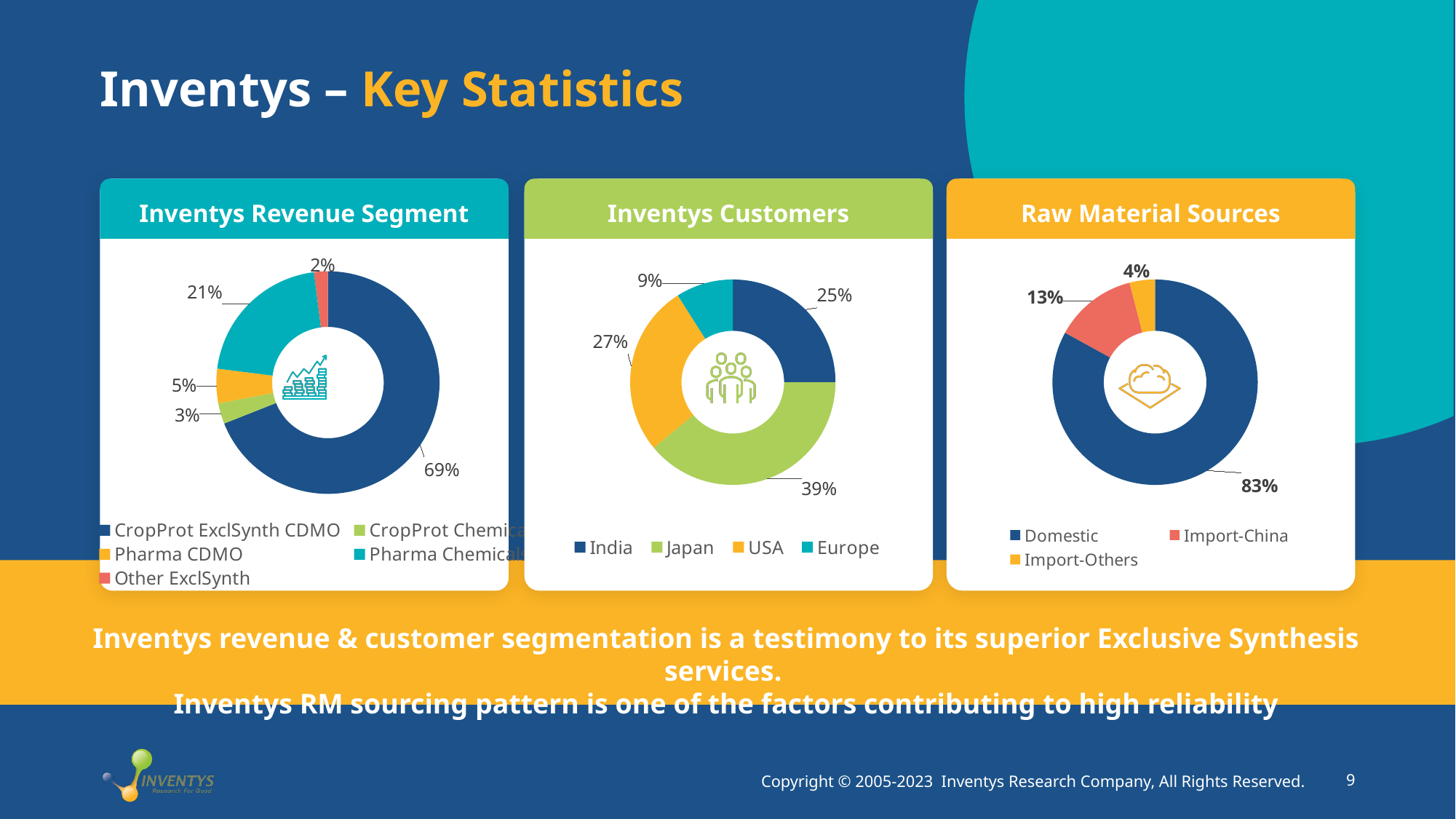
In the Inventys Customers chart, which region has the largest share? Japan In the Raw Material Sources chart, which is larger, Import-China or Import-Others? Import-China In the Inventys Customers chart, what is the difference between the USA share and the India share? 2% How many series does the legend of the Inventys Customers chart list? 4 What type of chart is the Raw Material Sources chart? Donut (pie) chart In the Raw Material Sources chart, what percentage of raw materials is Domestic? 83% In the Inventys Customers chart, what share of customers is from Japan? 39% In the Inventys Revenue Segment chart, what share does Pharma CDMO account for? 5% In the Inventys Revenue Segment chart, which segment has the smallest share? Other ExclSynth In the Inventys Revenue Segment chart, what share does CropProt ExclSynth CDMO account for? 69% In the Raw Material Sources chart, what percentage is Import-China? 13% In the Inventys Customers chart, what share of customers is from Europe? 9%